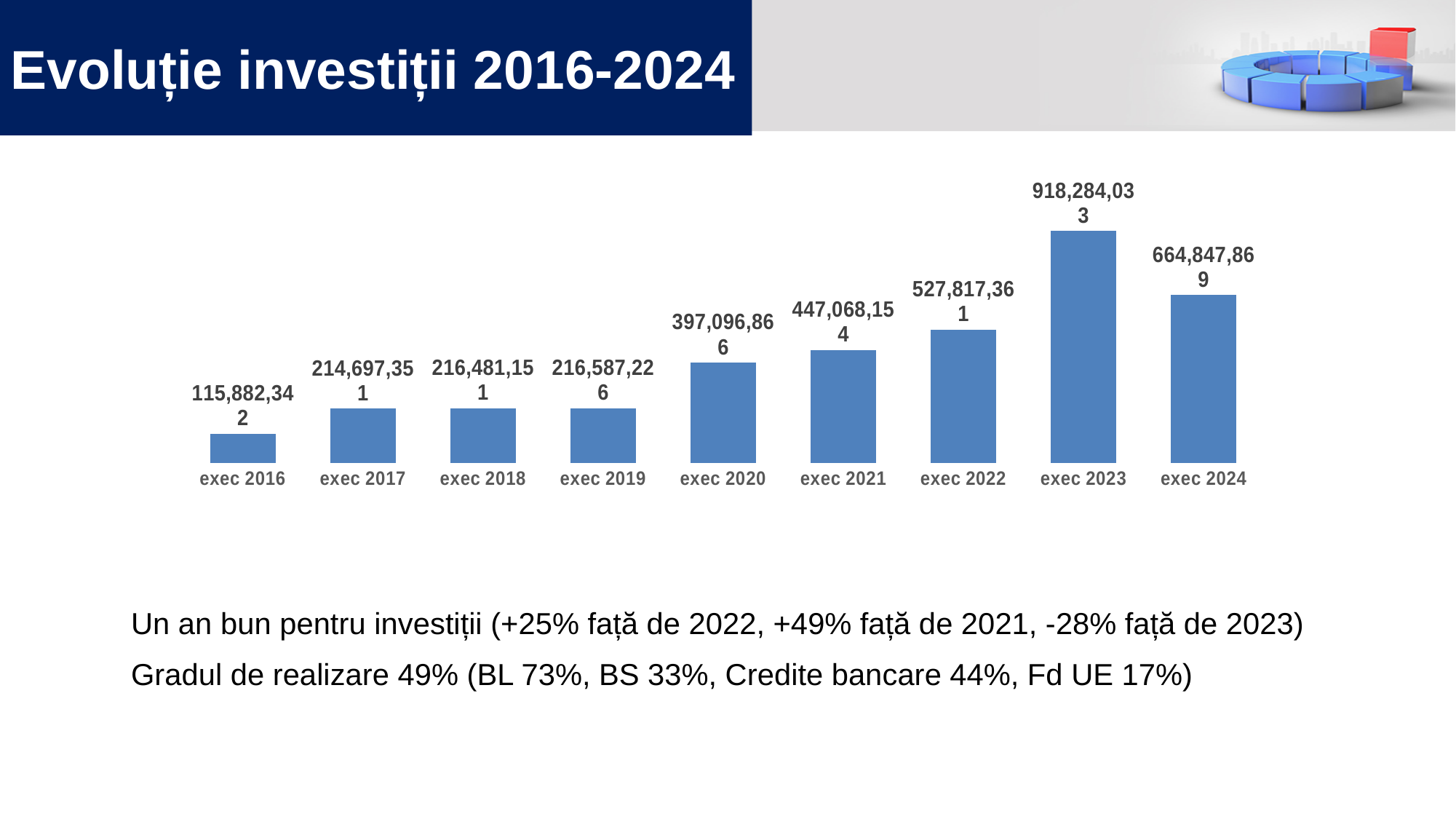
Which category has the lowest value? exec 2016 Which is larger, the value for exec 2020 or the value for exec 2021? exec 2021 What is the value for exec 2022? 527,817,361 Do the values rise or fall from exec 2016 to exec 2023? rise What is the value for exec 2024? 664,847,869 What is the difference between the values for exec 2023 and exec 2024? 253,436,164 How many categories are shown on the chart? 9 What kind of chart is shown on the slide? bar chart Which category has the highest value? exec 2023 What is the difference between the values for exec 2022 and exec 2021? 80,749,207 What is the value for exec 2020? 397,096,866 What is the value for exec 2016? 115,882,342